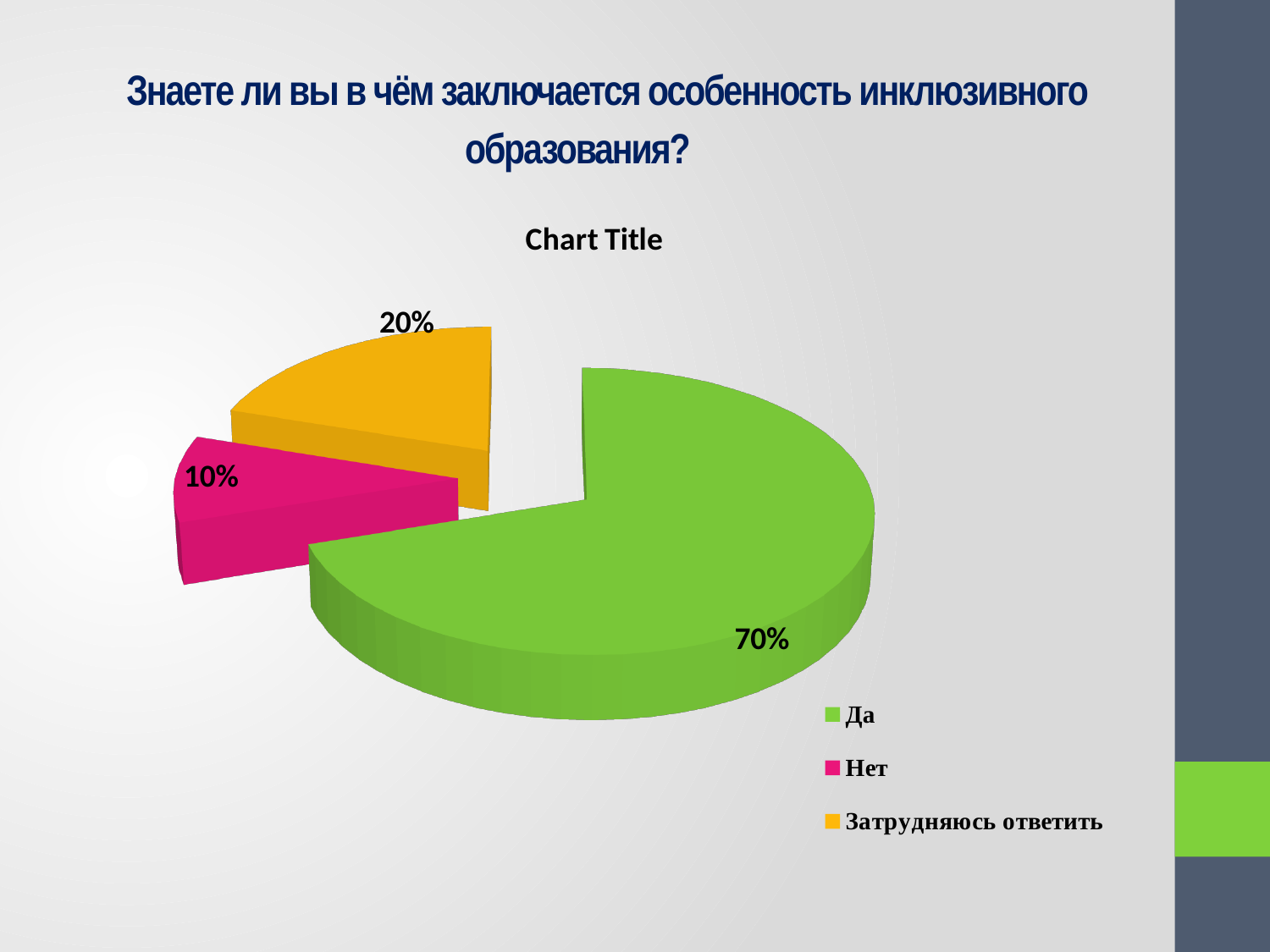
What percentage of the pie chart is labelled "Затрудняюсь ответить"? 20% Which category has the largest slice of the pie chart? Да What is the title shown above the pie chart? Chart Title What percentage of the pie chart is labelled "Нет"? 10% What is the difference in percentage points between the "Да" slice and the "Затрудняюсь ответить" slice? 50 How many entries does the legend list? 3 What kind of chart is shown on the slide? Pie chart What percentage of the pie chart is labelled "Да"? 70% Which category has the smallest slice of the pie chart? Нет How many slices does the pie chart have? 3 Which slice is larger, "Нет" or "Затрудняюсь ответить"? Затрудняюсь ответить What colour is the "Нет" slice in the pie chart? Pink